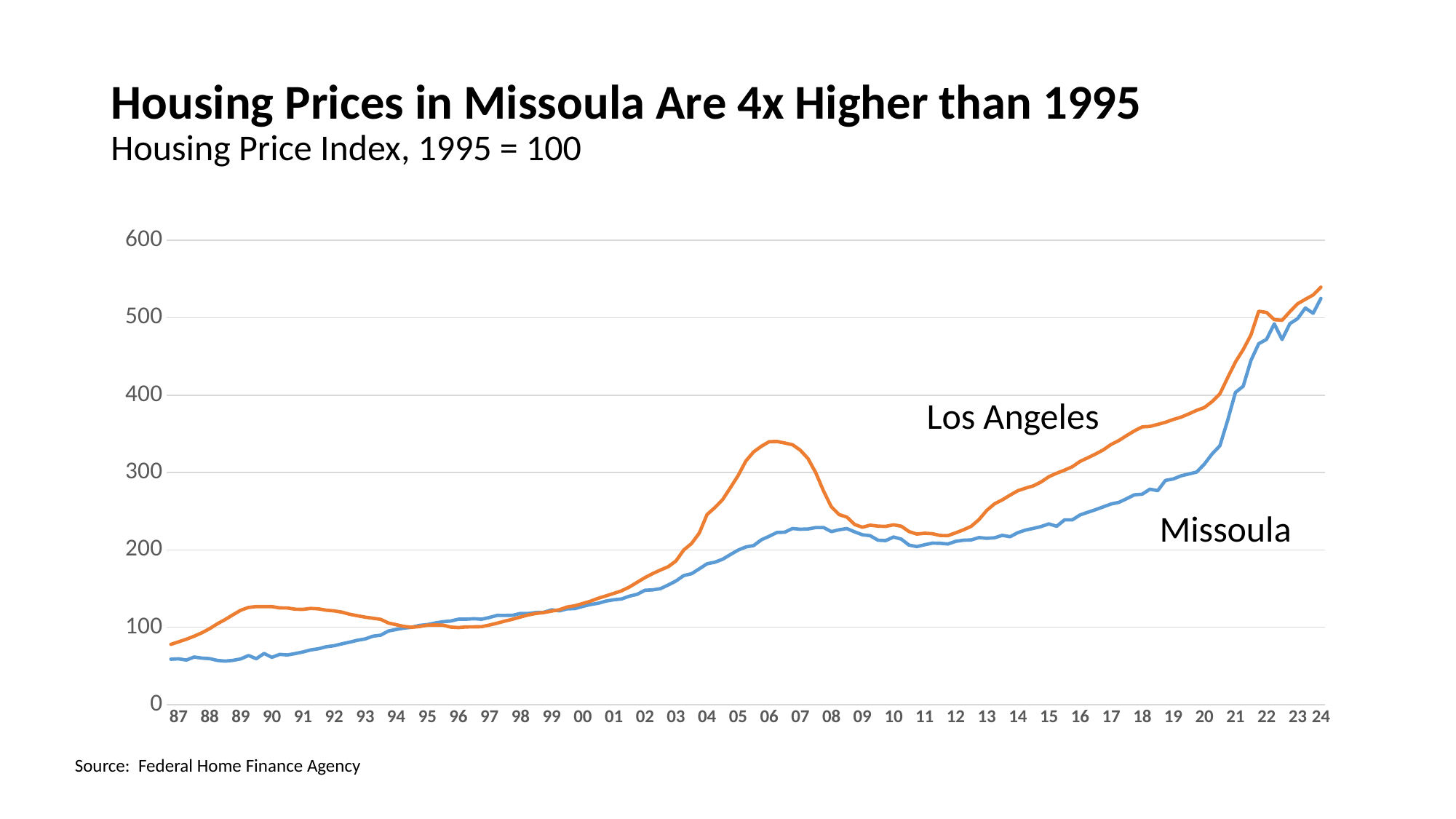
What kind of chart is shown on the slide? line chart Is the Los Angeles value in 2016 greater or less than 300? greater In 2006, which series has the higher value, Los Angeles or Missoula? Los Angeles Is the Los Angeles value at its 2006 peak greater or less than 300? greater Is the Los Angeles value in 2024 greater or less than 500? greater In 1992, which series has the higher value, Los Angeles or Missoula? Los Angeles What is the title of the chart? Housing Prices in Missoula Are 4x Higher than 1995 Which two series are labelled on the chart? Los Angeles and Missoula Does the Missoula line rise or fall between 2012 and 2024? rise How many series are plotted on the chart? 2 Does the Los Angeles line rise or fall between 2006 and 2009? fall